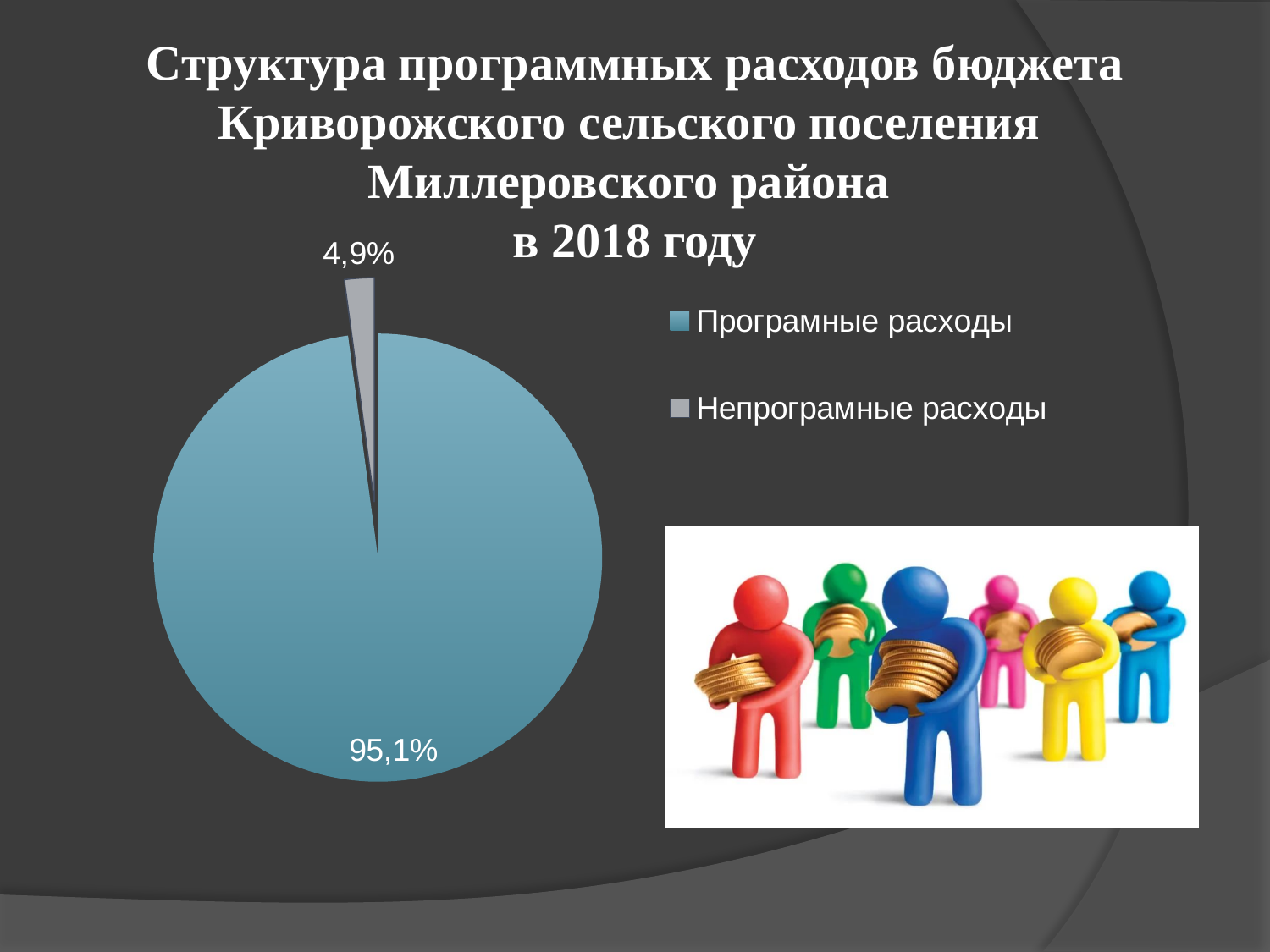
How many entries does the legend list? 2 Which year does the chart title refer to? 2018 What colour is the slice for Непрограмные расходы? grey Which is larger, the slice for Програмные расходы or the slice for Непрограмные расходы? Програмные расходы What kind of chart is shown on the slide? pie chart Which category has the smallest slice of the pie? Непрограмные расходы What is the difference in percentage points between Програмные расходы and Непрограмные расходы? 90,2 What share of the pie is labelled for Непрограмные расходы? 4,9% Which category has the largest slice of the pie? Програмные расходы How many slices does the pie chart have? 2 What share of the pie is labelled for Програмные расходы? 95,1%